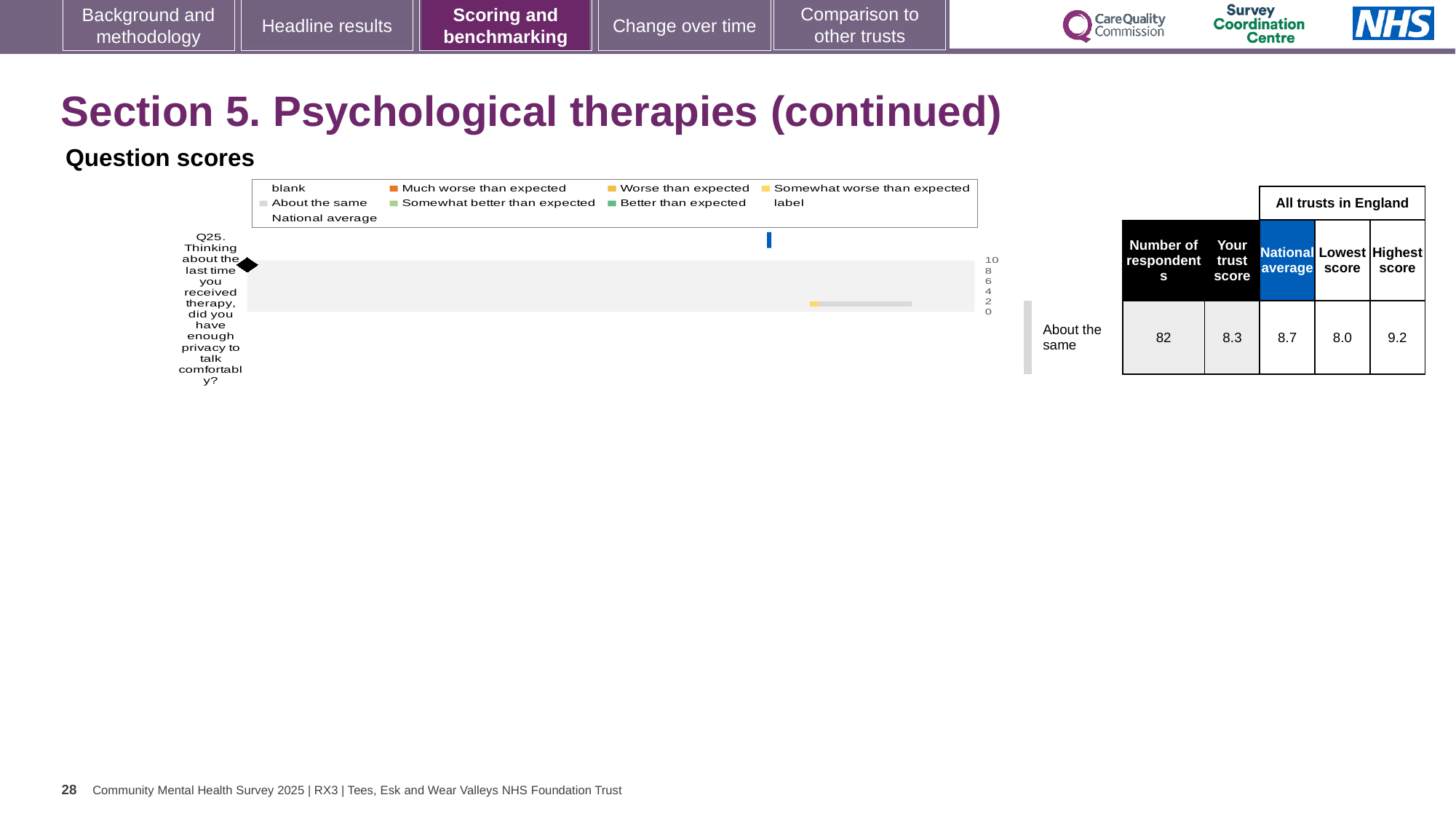
What is the difference between the highest and lowest scores for Q25 across all trusts in England? 1.2 How many respondents answered Q25? 82 By how much does the national average exceed the trust's score for Q25? 0.4 What is the highest score among all trusts in England for Q25? 9.2 What is the lowest score among all trusts in England for Q25? 8.0 What is the national average score for Q25? 8.7 What is the maximum value shown on the chart's score axis? 10 Which is larger for Q25, the trust's score or the national average? National average What kind of chart is shown on the slide? Bar chart What is the trust's score for Q25 (privacy to talk comfortably during therapy)? 8.3 How is the trust's Q25 score categorised relative to expectation? About the same How many questions are plotted in the chart? 1